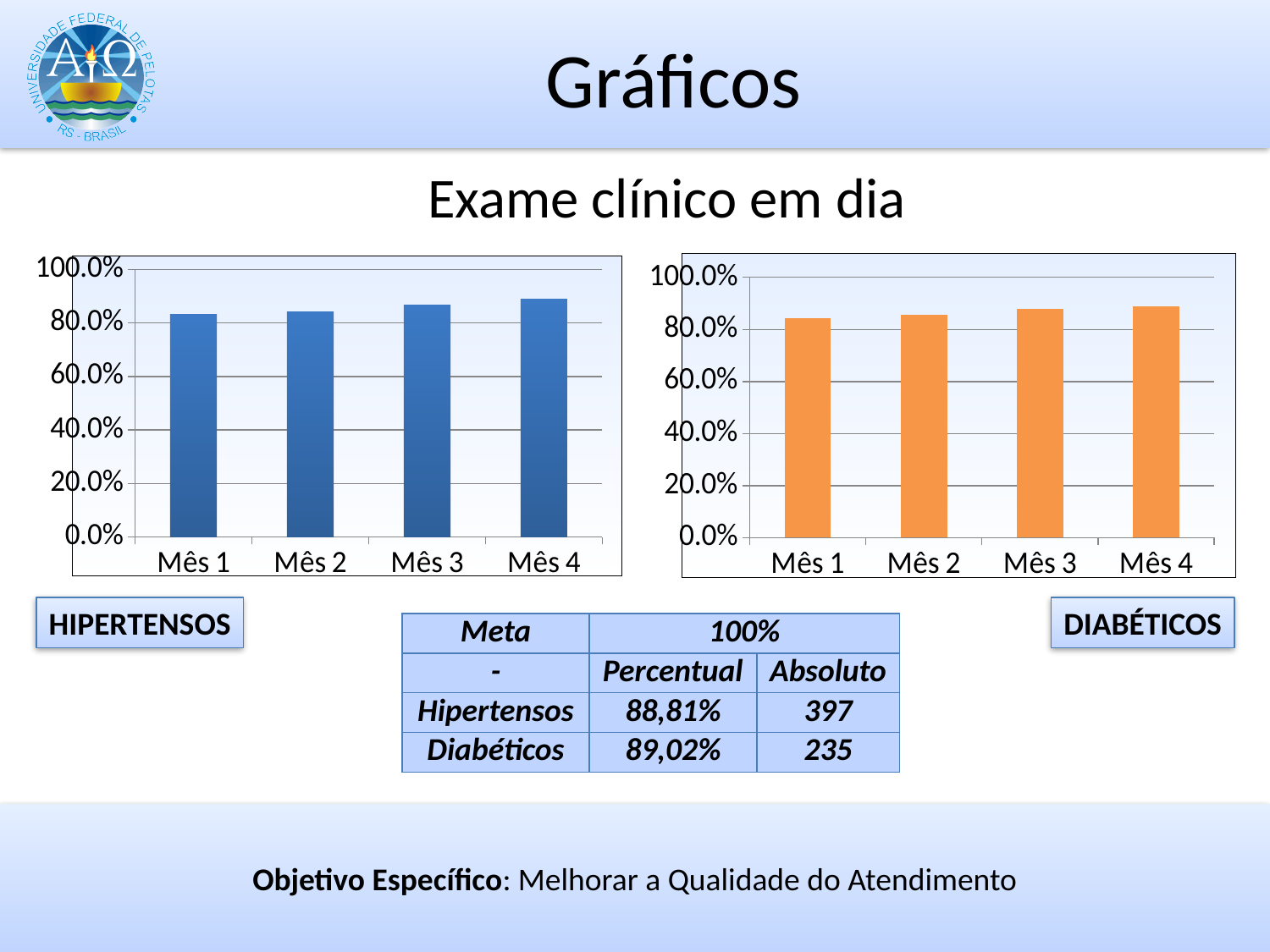
In the DIABÉTICOS chart on the right, which month has the highest value? Mês 4 What colour are the bars in the DIABÉTICOS chart on the right? orange In the HIPERTENSOS chart on the left, which month has the highest value? Mês 4 In the DIABÉTICOS chart on the right, is the value for Mês 4 greater or less than 100.0%? less In the HIPERTENSOS chart on the left, which is larger, the value for Mês 1 or the value for Mês 4? Mês 4 In the HIPERTENSOS chart on the left, which month has the lowest value? Mês 1 How many months are shown on the x axis of the DIABÉTICOS chart on the right? 4 What kind of chart is the HIPERTENSOS chart on the left? bar chart In the DIABÉTICOS chart on the right, is the value for Mês 2 greater or less than 60.0%? greater What is the shared title above the two charts? Exame clínico em dia In the DIABÉTICOS chart on the right, do the values rise or fall from Mês 1 to Mês 4? rise In the HIPERTENSOS chart on the left, is the value for Mês 1 greater or less than 80.0%? greater